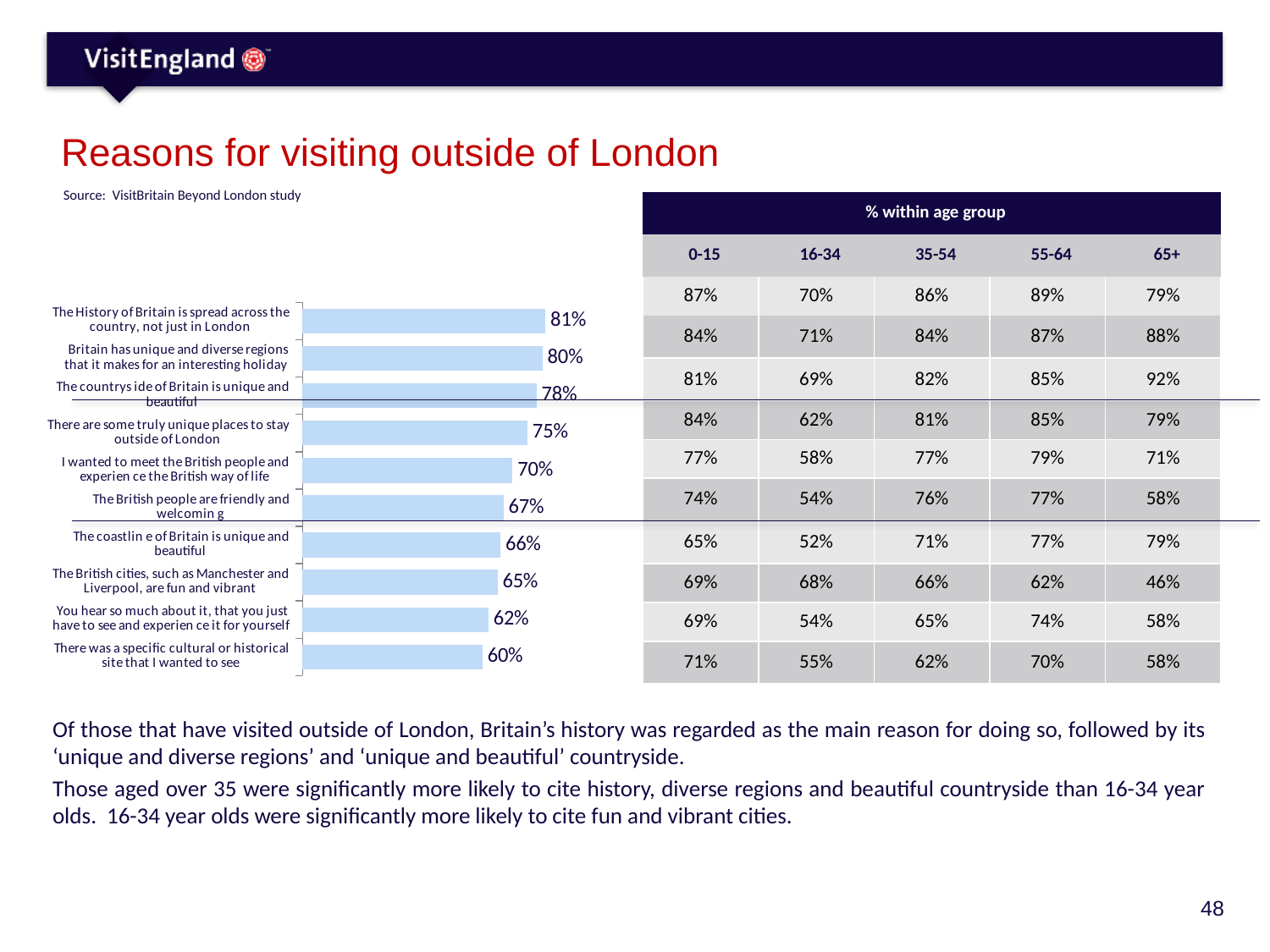
Which reason has the lowest value in the bar chart? There was a specific cultural or historical site that I wanted to see What is the title of the slide containing the bar chart? Reasons for visiting outside of London Which reason has the highest value in the bar chart? The History of Britain is spread across the country, not just in London What is the value for 'The History of Britain is spread across the country, not just in London'? 81% What is the value for 'There was a specific cultural or historical site that I wanted to see'? 60% What is the value for 'The countryside of Britain is unique and beautiful'? 78% Which is larger: the value for 'I wanted to meet the British people and experience the British way of life' or 'The coastline of Britain is unique and beautiful'? I wanted to meet the British people and experience the British way of life How many reasons (categories) are plotted in the bar chart? 10 What kind of chart is shown on the slide? Bar chart What is the difference between the value for 'There are some truly unique places to stay outside of London' and 'The British people are friendly and welcoming'? 8% What is the value for 'The British cities, such as Manchester and Liverpool, are fun and vibrant'? 65% Do the bar values rise or fall going from the top category to the bottom category? Fall